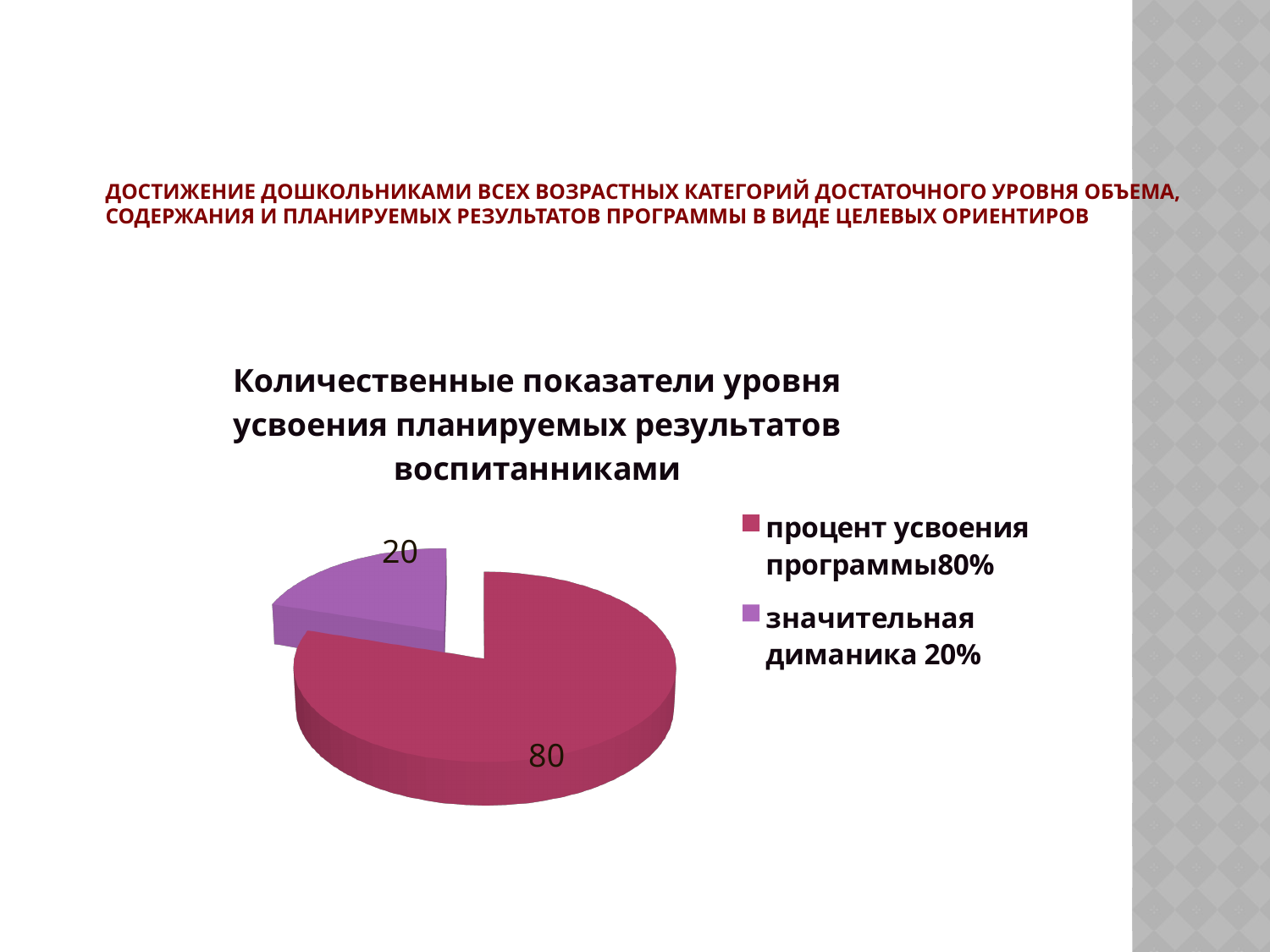
Which is larger: the slice for "процент усвоения программы80%" or the slice for "значительная диманика 20%"? процент усвоения программы80% Which slice of the pie chart is the largest? процент усвоения программы80% How many entries does the legend list? 2 What share of the pie does the "значительная диманика 20%" slice represent? 20% What colour is the slice labelled 20? purple Which slice of the pie chart is the smallest? значительная диманика 20% What is the difference between the two slice values shown on the pie chart? 60 What is the data label on the slice for "процент усвоения программы80%"? 80 What is the title of the chart? Количественные показатели уровня усвоения планируемых результатов воспитанниками What is the data label on the slice for "значительная диманика 20%"? 20 What type of chart is shown on the slide? pie chart How many slices does the pie chart have? 2